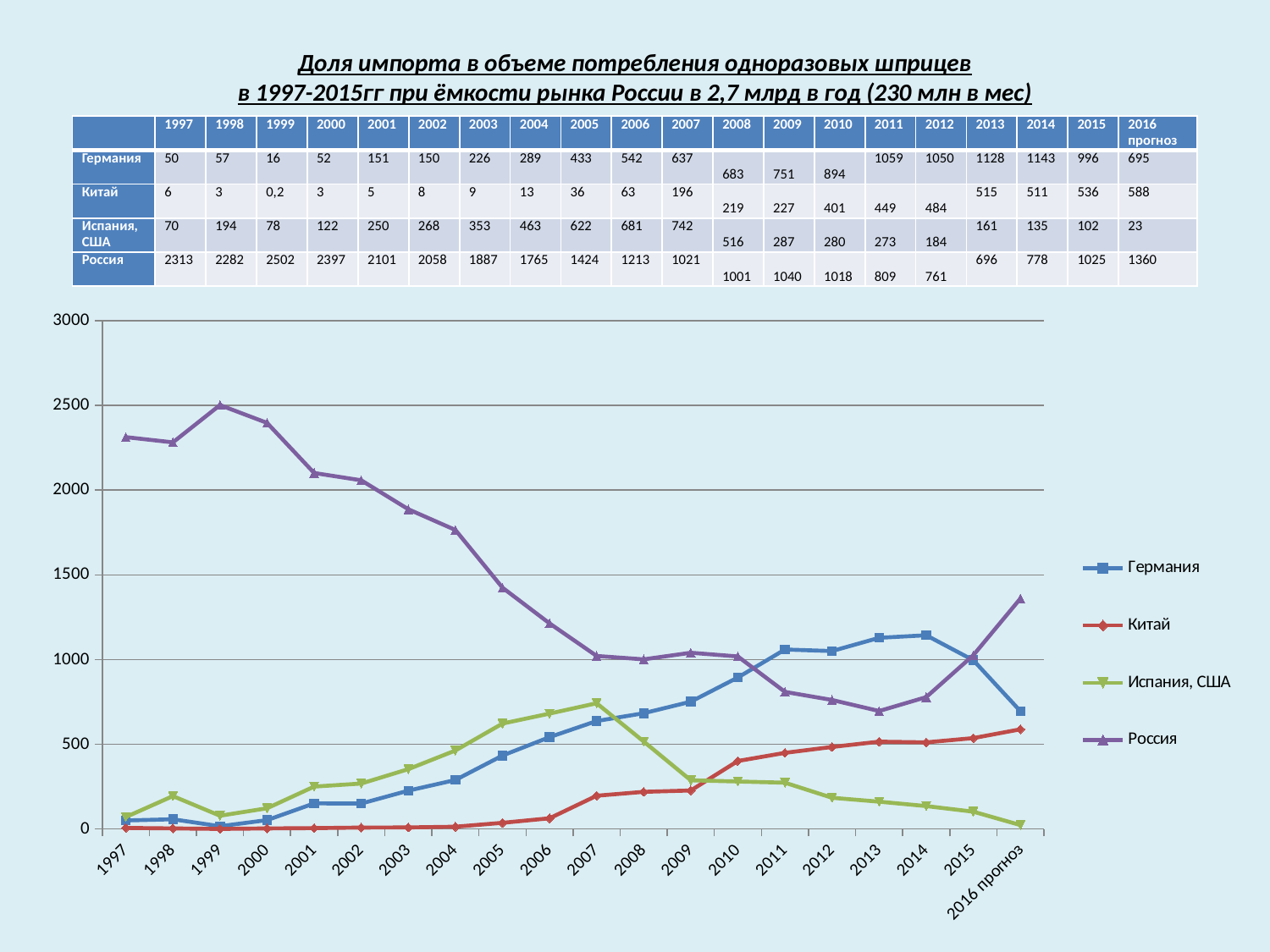
In which year does the Россия series reach its highest value? 1999 What is the value for Россия in 1999? 2502 What is the value for Германия in 2014? 1143 What kind of chart is shown on the slide? line chart In 2010, which is larger: the value for Германия or the value for Россия? Россия Does the Россия series rise or fall from 1997 to 2007? fall What is the difference between the Германия values for 2014 and 2015? 147 Is the value for Испания, США in 2007 greater or less than 500? greater What colour is the Россия line in the chart? purple How many series does the chart legend list? 4 How many points are plotted along the x axis of the chart? 20 In which year does the Китай series have its lowest value? 1999